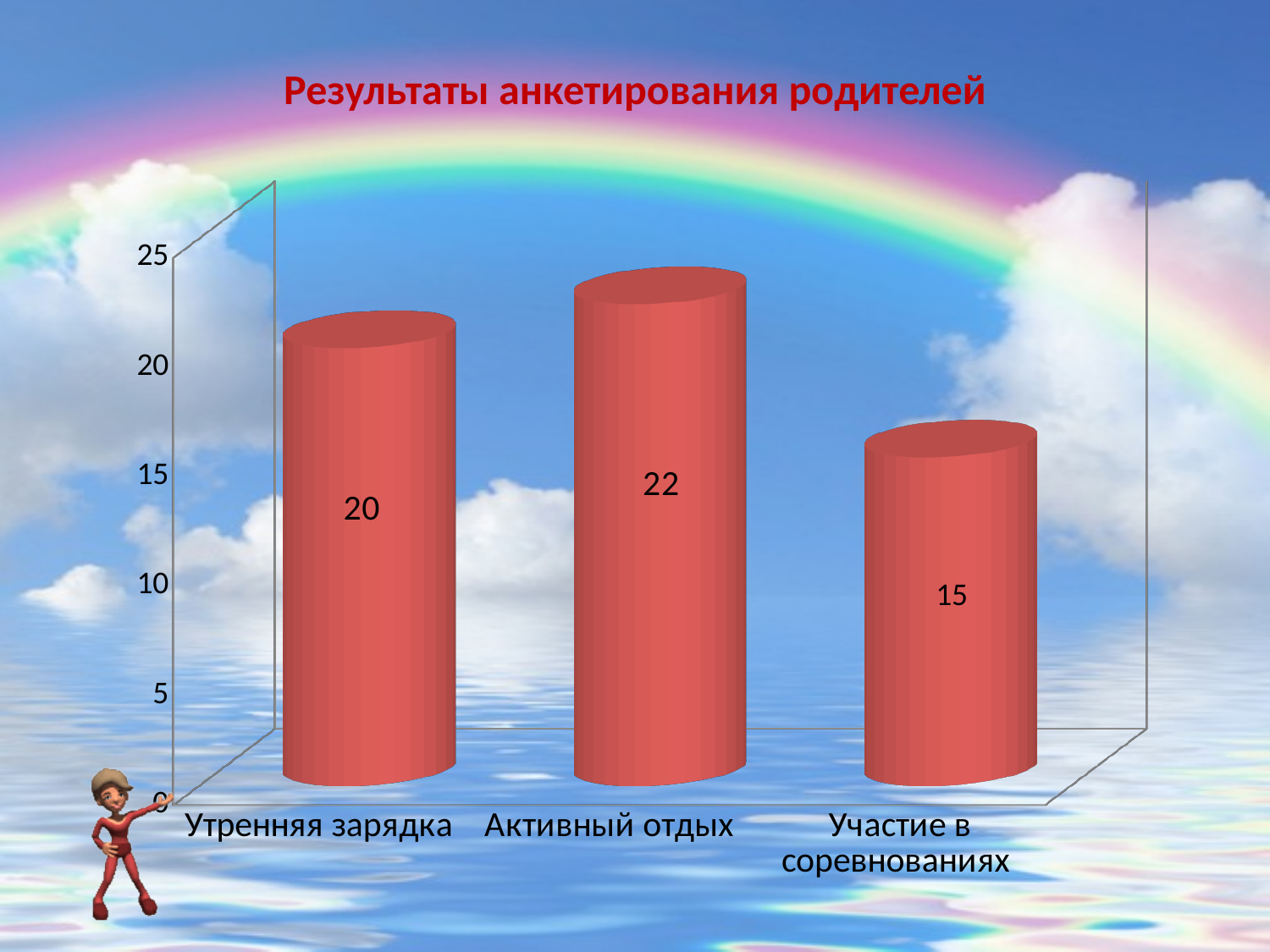
Which category has the highest value? Активный отдых What is the title of the slide? Результаты анкетирования родителей What kind of chart is shown on the slide? bar chart Is the value for Участие в соревнованиях greater or less than 20? less What is the difference between the values for Активный отдых and Участие в соревнованиях? 7 What is the value for Утренняя зарядка? 20 What is the value for Активный отдых? 22 Which is larger, the value for Утренняя зарядка or the value for Участие в соревнованиях? Утренняя зарядка What is the value for Участие в соревнованиях? 15 What is the difference between the values for Активный отдых and Утренняя зарядка? 2 Which category has the lowest value? Участие в соревнованиях How many categories are shown in the chart? 3